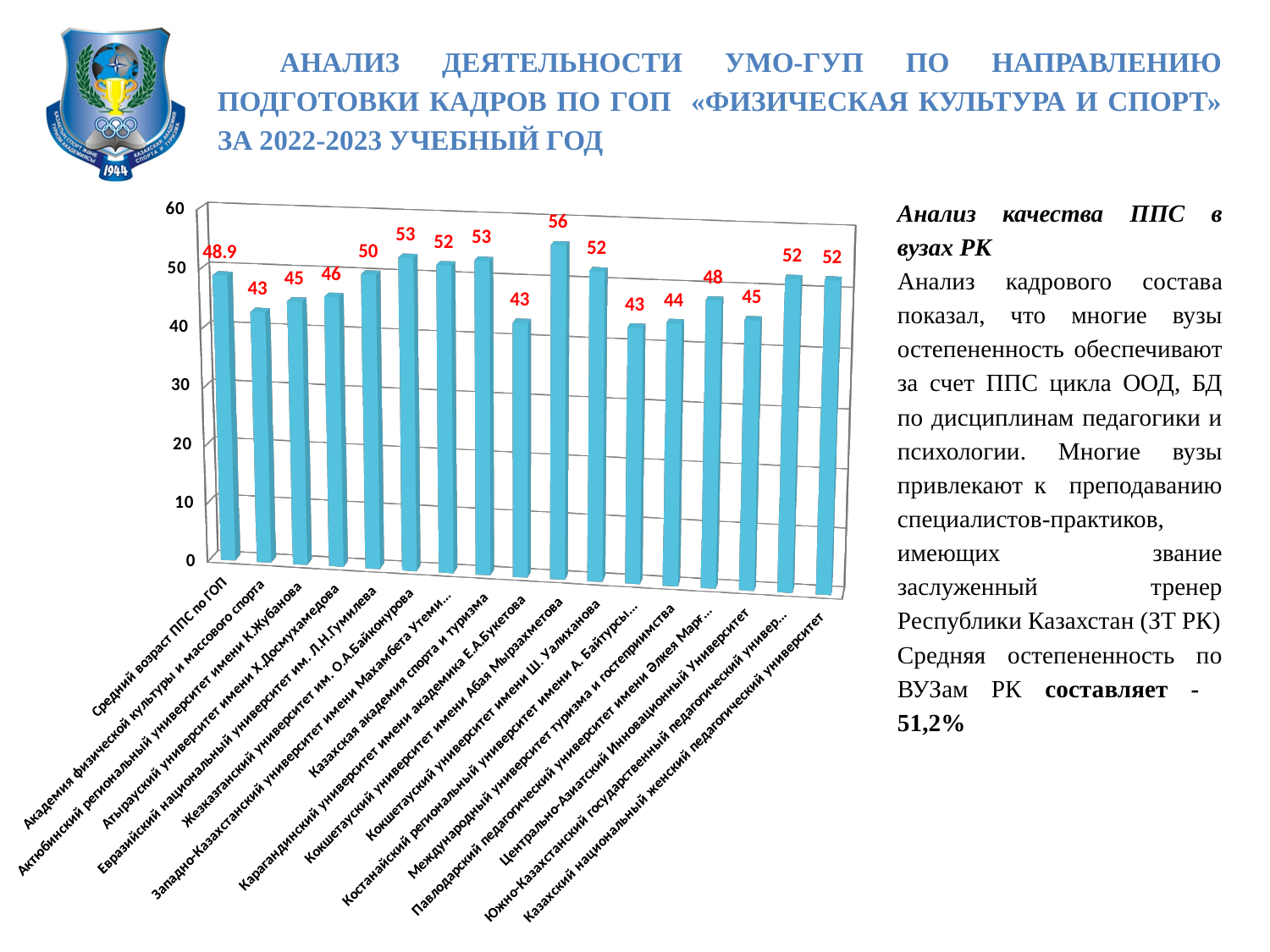
What colour are the bars in the chart? light blue What value is shown for Казахская академия спорта и туризма? 53 What value is shown for Евразийский национальный университет им. Л.Н.Гумилева? 50 What is the difference between the value for Кокшетауский университет имени Абая Мырзахметова and the value for Карагандинский университет имени академика Е.А.Букетова? 13 Which is larger: the value for Жезказганский университет им. О.А.Байконурова or the value for Атырауский университет имени Х.Досмухамедова? Жезказганский университет им. О.А.Байконурова What value is shown for Международный университет туризма и гостеприимства? 44 What kind of chart is shown on the slide? bar chart What is the lowest value shown in the chart? 43 Which category has the highest value in the chart? Кокшетауский университет имени Абая Мырзахметова What value is shown for Средний возраст ППС по ГОП? 48.9 Is the value for Павлодарский педагогический университет greater or less than 50? less How many bars are plotted in the chart? 17